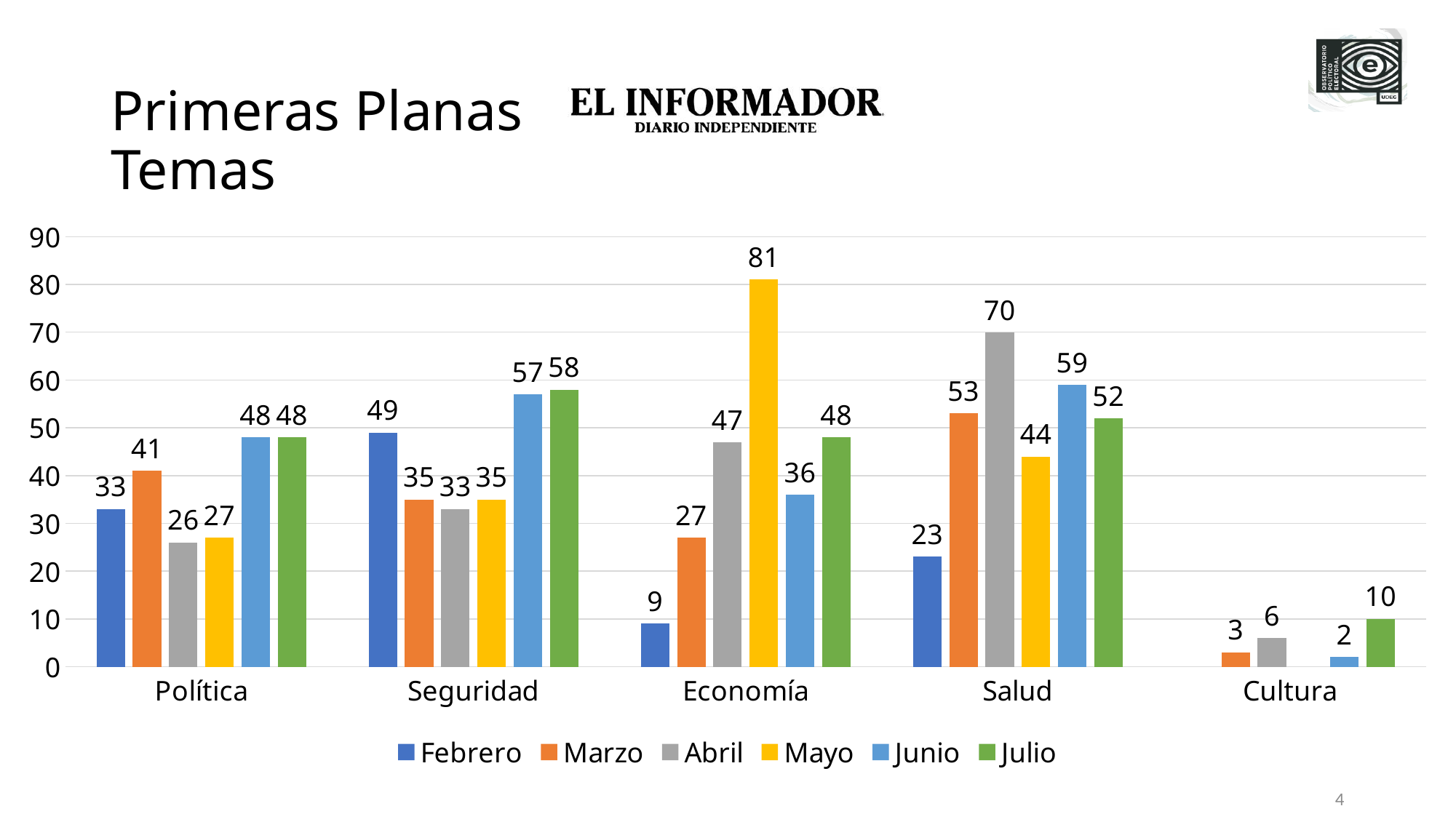
What is the value for Febrero in the Seguridad category? 49 Which month has the highest value in the Salud category? Abril Which is larger in the Política category, the Marzo value or the Abril value? Marzo Which colour represents Mayo in the legend? Yellow What kind of chart is shown on the slide? Bar chart What is the value for Abril in the Salud category? 70 What is the value for Julio in the Cultura category? 10 How many series does the legend list? 6 What is the difference between the Mayo and Junio values in the Economía category? 45 What is the value for Mayo in the Economía category? 81 How many categories are shown on the x axis? 5 Which month has the lowest value in the Economía category? Febrero